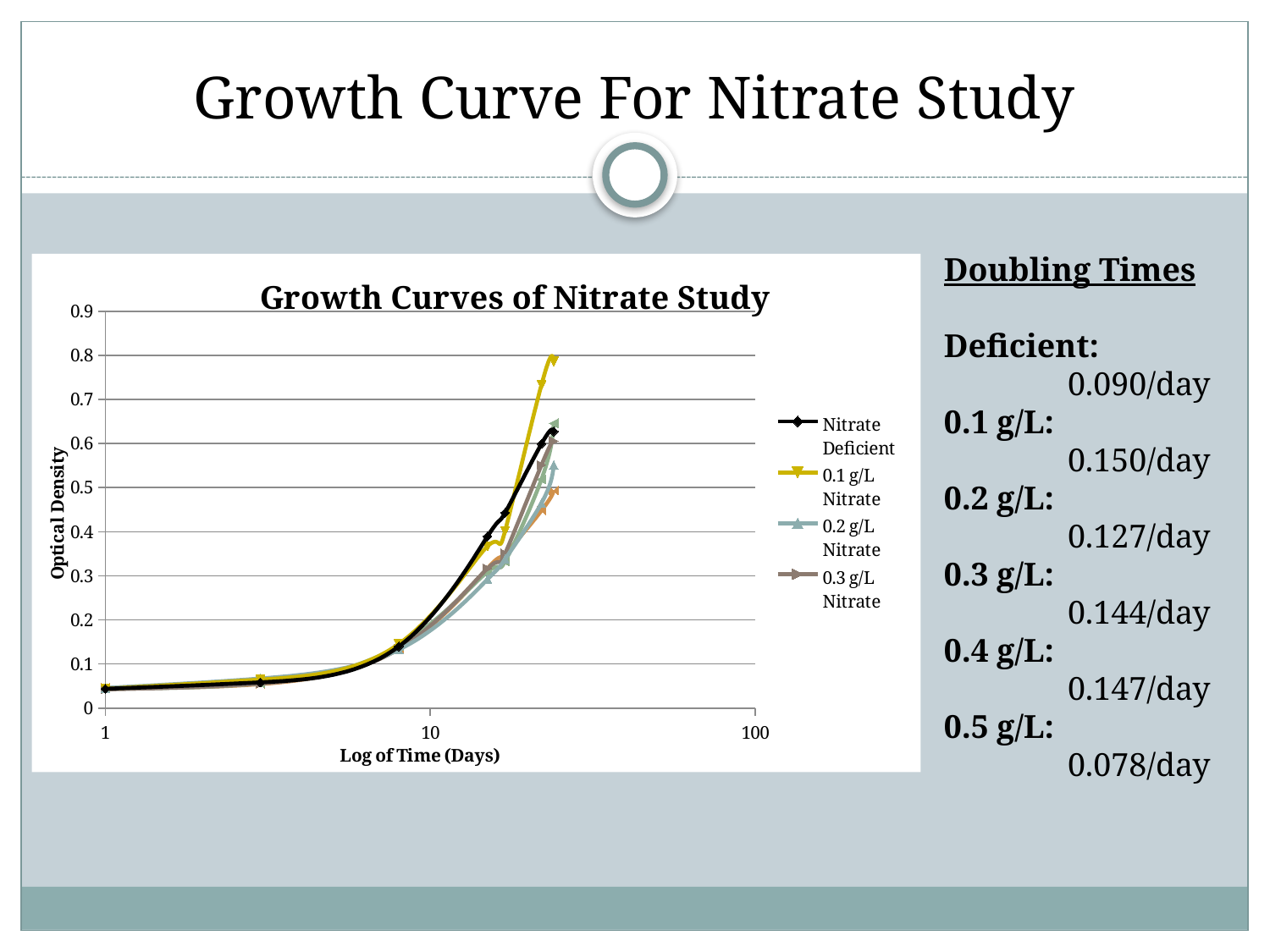
Which series reaches the highest optical density at the end of the curves? 0.1 g/L Nitrate Are the optical density values at day 1 greater or less than 0.1? less Is the highest value reached by the Nitrate Deficient series greater or less than 0.7? less How many series does the chart's legend list? 4 What is the title of the chart? Growth Curves of Nitrate Study Is the highest value reached by the Nitrate Deficient series greater or less than 0.5? greater What is the label of the chart's y axis? Optical Density What kind of chart is shown on the slide? line chart Do the optical density values rise or fall as time increases along the x axis? rise At the end of the curves, which is larger: the value for 0.1 g/L Nitrate or the value for Nitrate Deficient? 0.1 g/L Nitrate